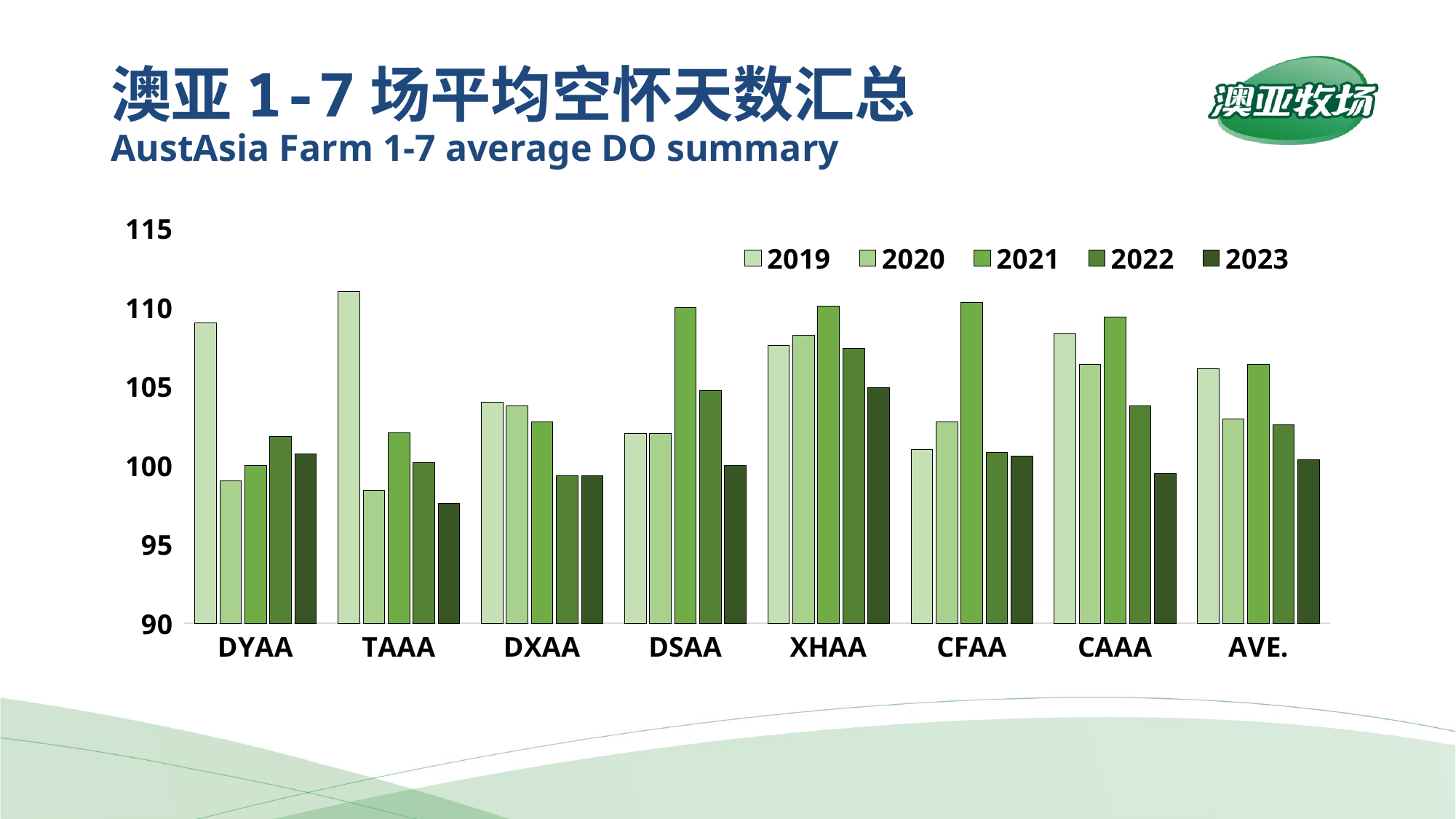
For TAAA, which year has the lowest value? 2023 Is the 2019 value for TAAA greater or less than 110? greater Is the 2023 value for TAAA greater or less than 100? less Which category has the lowest 2023 value? TAAA How many series does the legend list? 5 For DSAA, which is larger: the 2021 value or the 2019 value? 2021 How many categories are shown along the x axis? 8 What kind of chart is shown on the slide? bar chart For AVE., do the values rise or fall from 2021 to 2023? fall For TAAA, which year has the highest value? 2019 Is the 2019 value for DYAA greater or less than 105? greater Which category has the highest 2019 value? TAAA